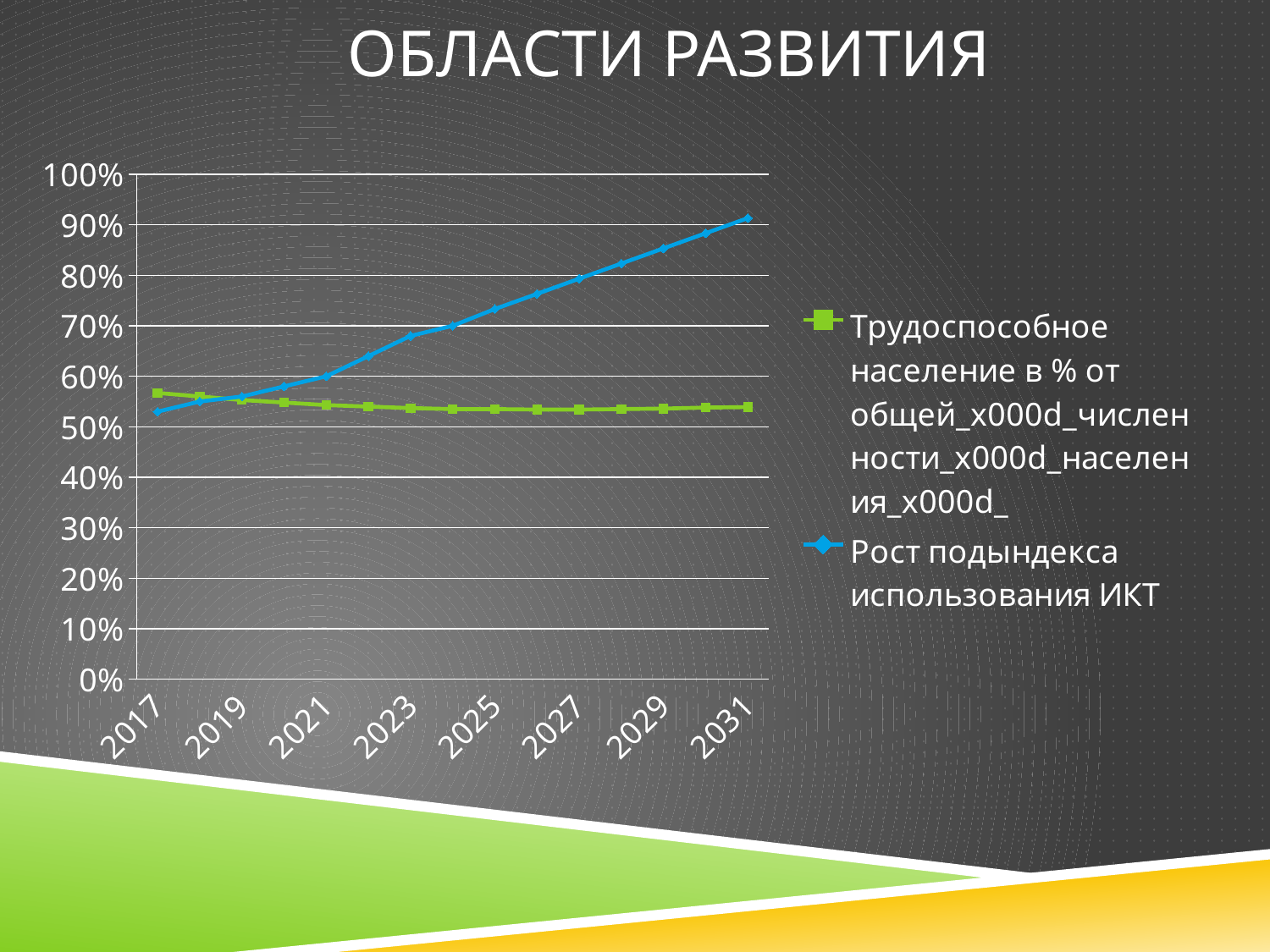
What kind of chart is shown on the slide? line chart Is the value for 'Трудоспособное население' in 2031 greater or less than 60%? less Does the value for 'Рост подындекса использования ИКТ' rise or fall from 2017 to 2031? rise In which year is 'Рост подындекса использования ИКТ' at its lowest value? 2017 Is the value for 'Рост подындекса использования ИКТ' in 2023 greater or less than 60%? greater Which colour is used for the series 'Рост подындекса использования ИКТ'? blue What is the title of the slide containing the chart? ОБЛАСТИ РАЗВИТИЯ In which year does 'Рост подындекса использования ИКТ' reach its highest value? 2031 In 2031, which series has the larger value: 'Трудоспособное население' or 'Рост подындекса использования ИКТ'? Рост подындекса использования ИКТ How many series does the legend list? 2 Is the value for 'Рост подындекса использования ИКТ' in 2017 greater or less than 60%? less